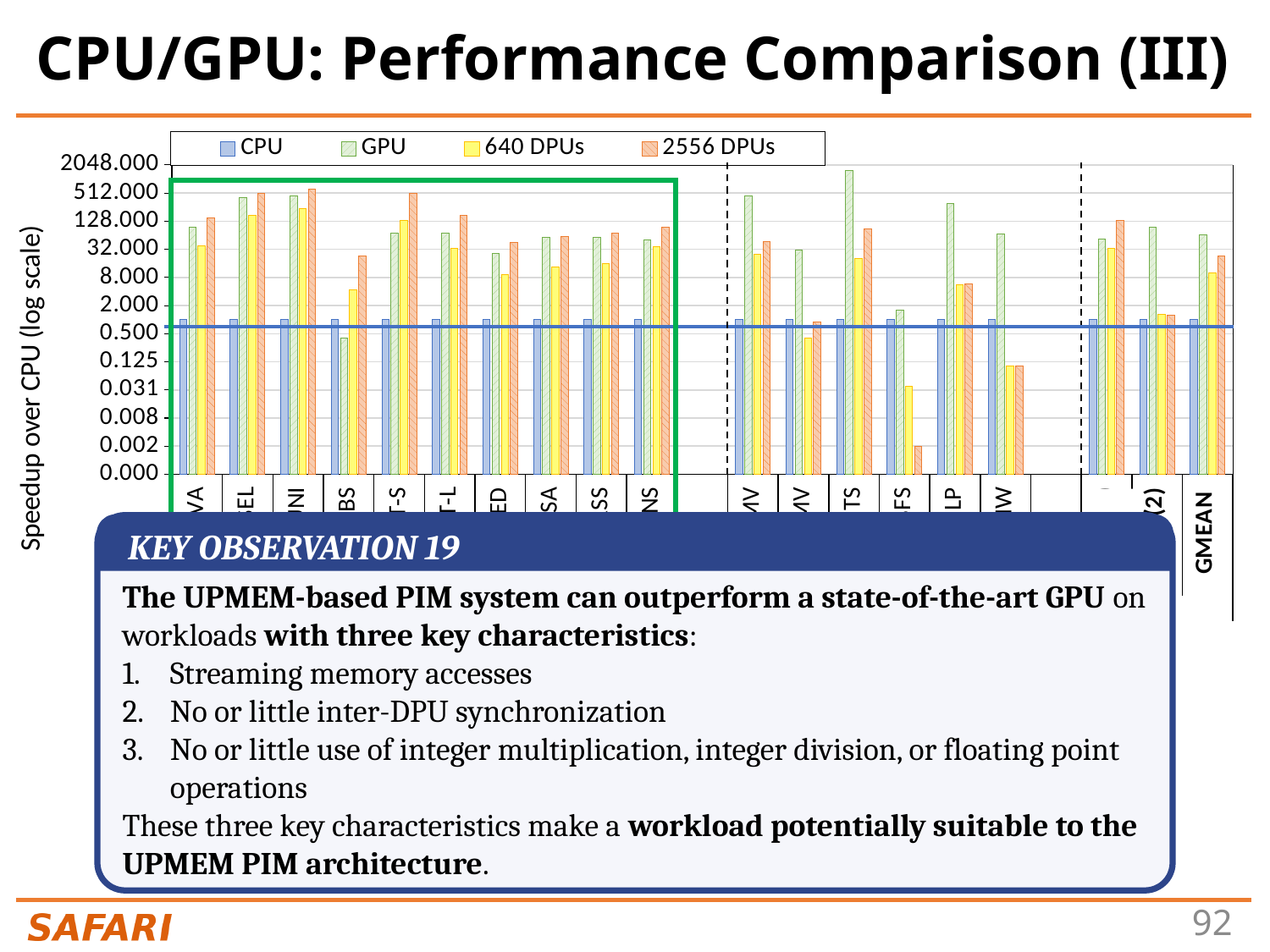
Is the 640 DPUs value for GMEAN greater or less than 32.000? less Is the GPU value for GMEAN greater or less than 32.000? greater How many series does the chart legend list? 4 For GMEAN, which series has the lowest value? CPU For GMEAN, which series has the highest value? GPU What are the four series listed in the chart legend? CPU, GPU, 640 DPUs, 2556 DPUs Is the 2556 DPUs value for GMEAN greater or less than 8.000? greater For GMEAN, which is larger: the 640 DPUs value or the 2556 DPUs value? 2556 DPUs For GMEAN, which is larger: the GPU value or the 2556 DPUs value? GPU What kind of chart is shown on the slide? bar chart What is the label of the chart's y-axis? Speedup over CPU (log scale)